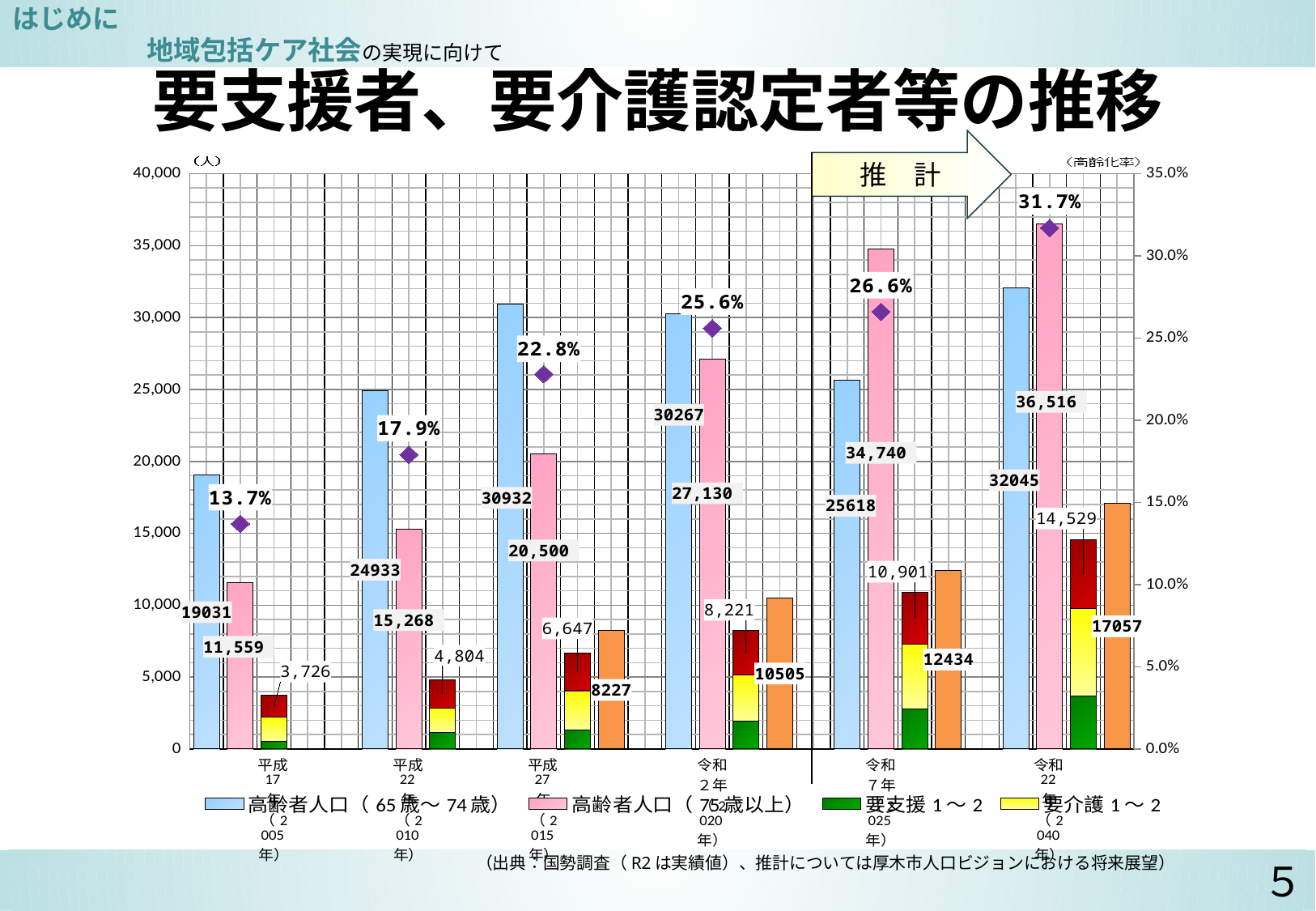
By how much does 高齢者人口（75歳以上） increase from 令和7年 to 令和22? 1,776 In 令和2年 (2020年), which is larger: 高齢者人口（65歳～74歳） or 高齢者人口（75歳以上）? 高齢者人口（65歳～74歳） What is the value of 高齢者人口（65歳～74歳） for 平成17 (2005年)? 19031 How many time periods are shown on the x axis? 6 What label is shown in the arrow above the last two periods of the chart? 推計 By how many percentage points does the 高齢化率 rise from 平成17 to 令和22? 18.0 percentage points In which year is 高齢者人口（65歳～74歳） highest? 令和22 (2040年), 32045 What is the value of 高齢者人口（75歳以上） for 令和22 (2040年)? 36,516 In which year is the 高齢化率 highest? 令和22 (2040年), 31.7% Is the 高齢化率 for 平成17 greater or less than 15.0%? less Does 高齢者人口（75歳以上） rise or fall across the years shown? rises What is the 高齢化率 shown for 令和7年 (2025年)? 26.6%